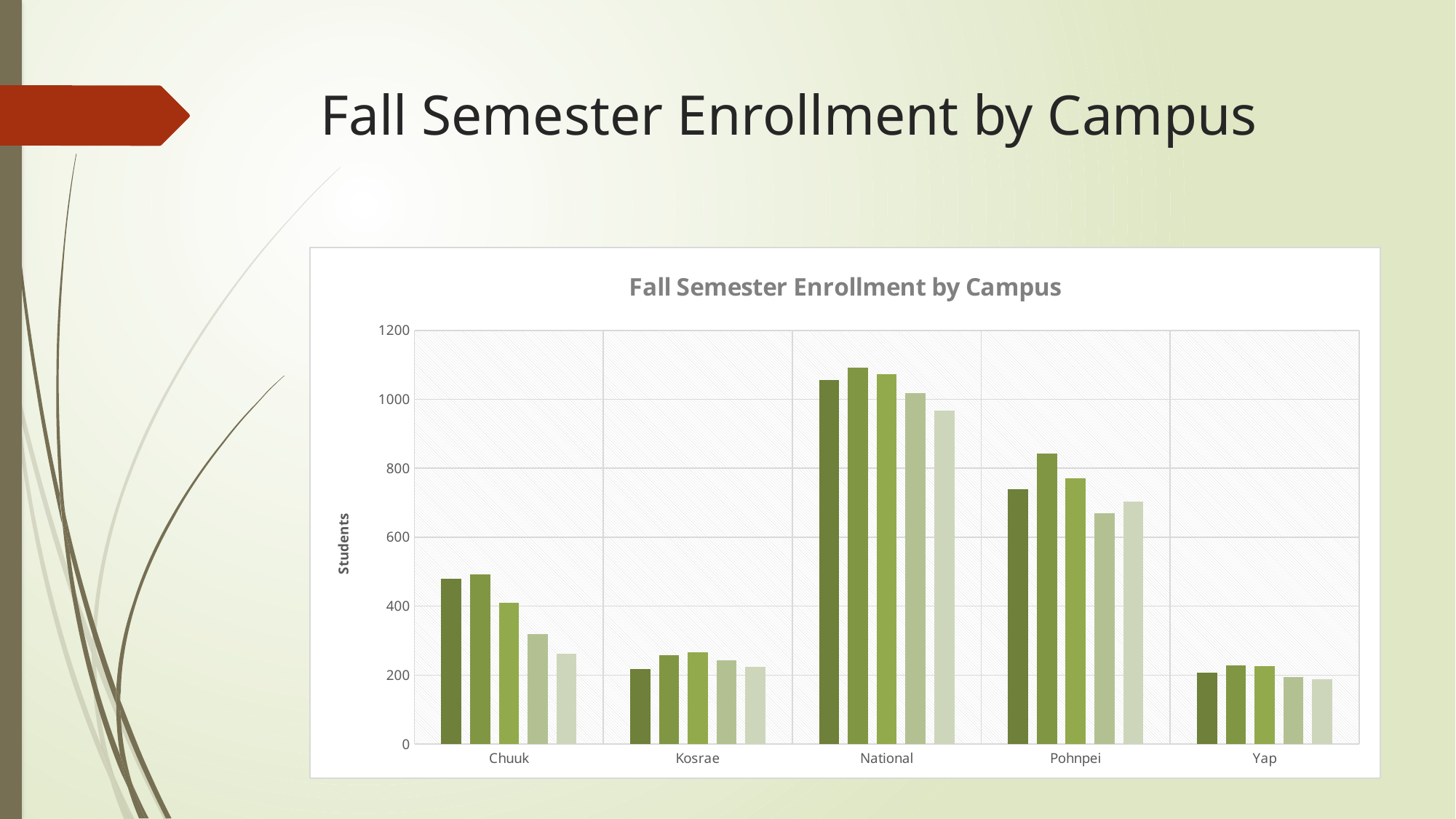
Which campus has higher enrollment, National or Pohnpei? National Are the bars for National greater or less than 800? greater What is the label on the y axis of the chart? Students Are the bars for Kosrae greater or less than 400? less How many campuses are shown on the x axis of the chart? 5 Which campus has the lowest enrollment in the chart? Yap Which campus has the highest enrollment in the chart? National How many bars are plotted for each campus in the chart? 5 What kind of chart is shown on the slide? bar chart Is the tallest bar for Chuuk greater or less than 600? less Which campus has higher enrollment, Pohnpei or Chuuk? Pohnpei What is the title of the chart? Fall Semester Enrollment by Campus